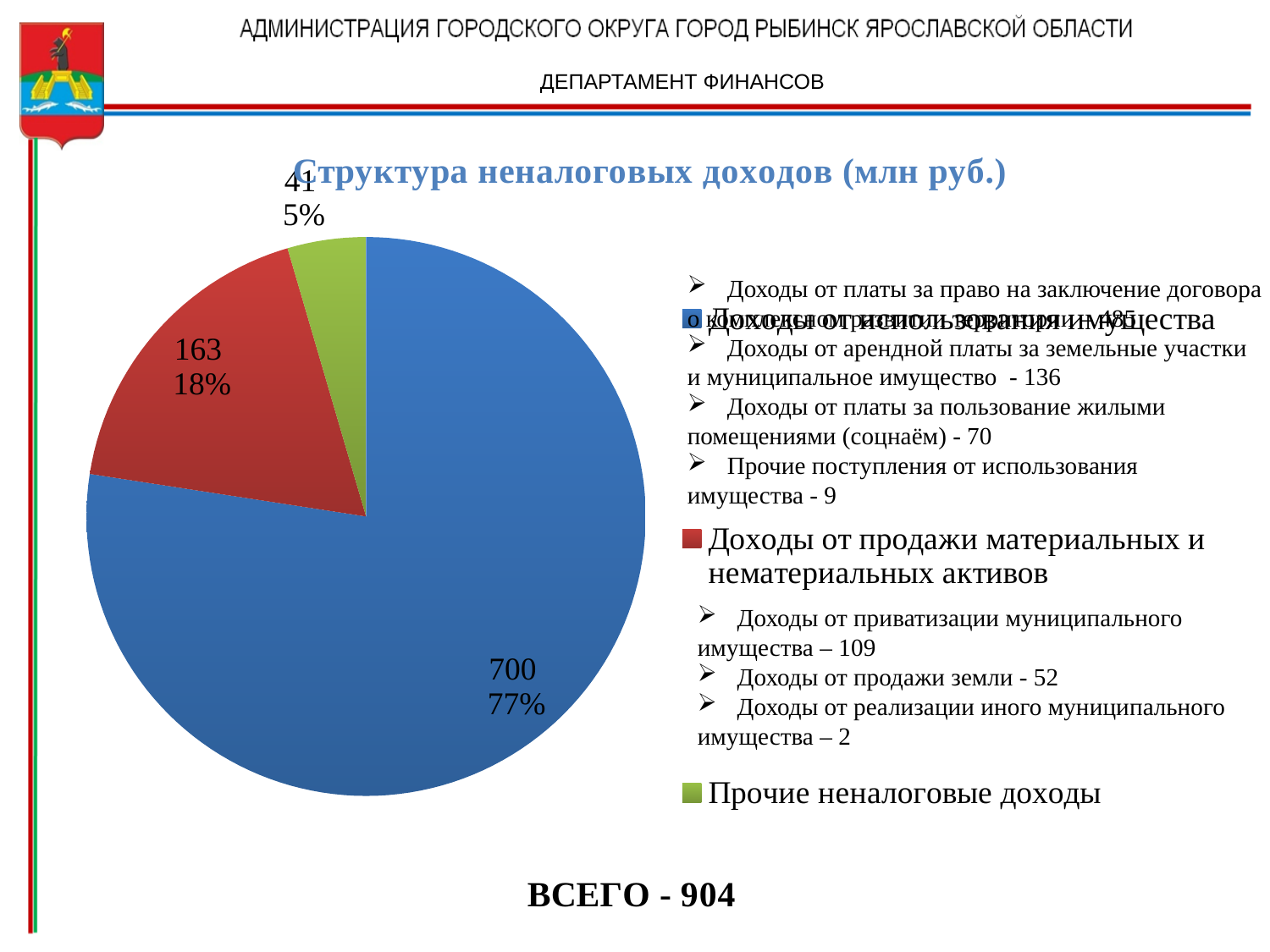
What is the value of the smallest slice of the pie chart? 41 What is the value of the largest slice of the pie chart? 700 What is the title of the pie chart? Структура неналоговых доходов (млн руб.) What share of the pie does the slice labelled 163 represent? 18% What share of the pie does the slice labelled 41 represent? 5% What is the value of the slice for 'Доходы от продажи материальных и нематериальных активов'? 163 What kind of chart is shown on the slide? pie chart What share of the pie does the slice labelled 700 represent? 77% What is the value of the slice for 'Прочие неналоговые доходы'? 41 What is the difference between the slice labelled 700 and the slice labelled 163? 537 How many slices does the pie chart have? 3 How many entries does the legend of the pie chart list? 3